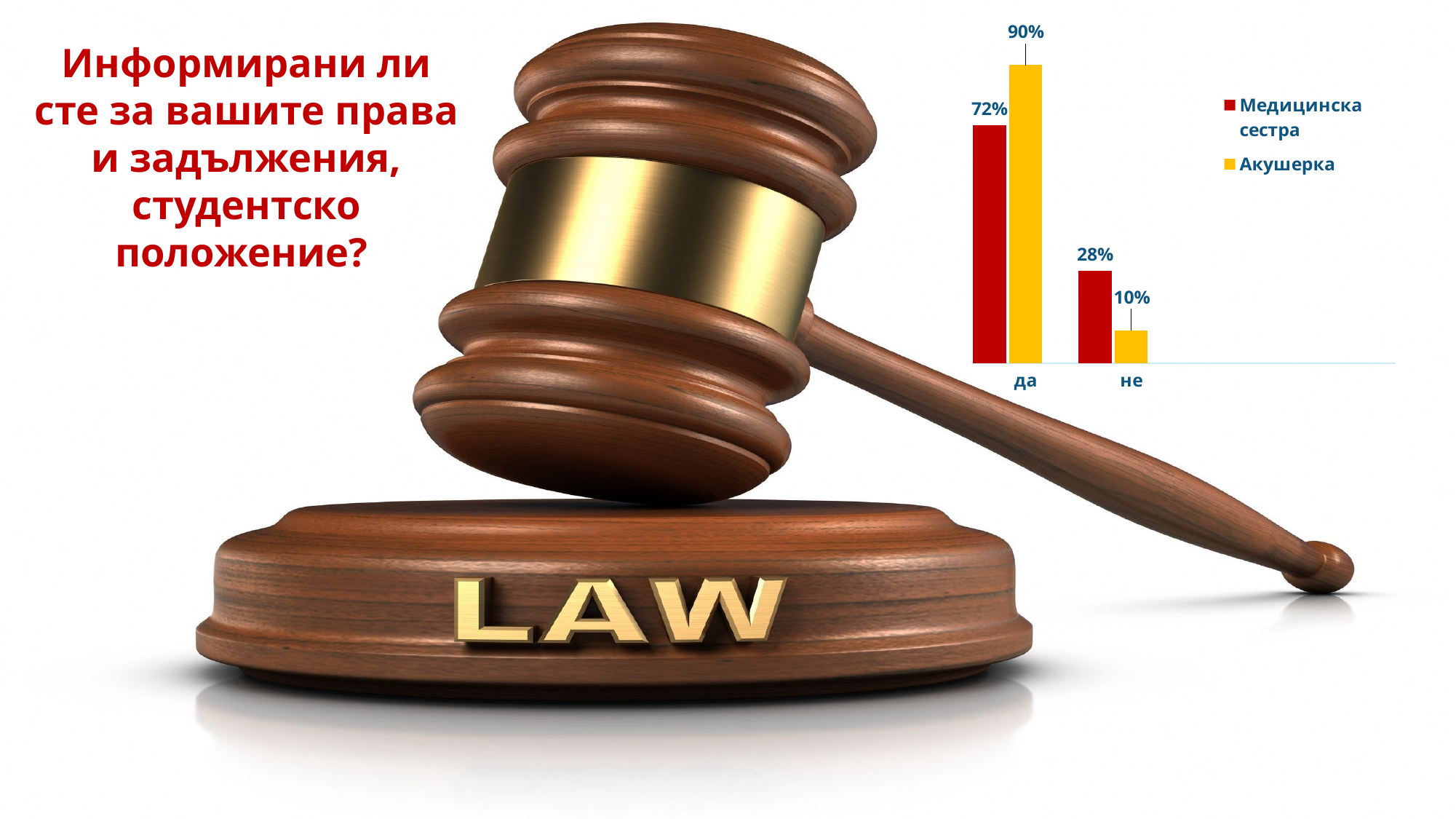
What is the value for Акушерка in the да category? 90% What is the difference between the Акушерка and Медицинска сестра values in the да category? 18% What is the value for Медицинска сестра in the не category? 28% How many categories are shown on the x axis? 2 What is the value for Медицинска сестра in the да category? 72% How many series does the legend list? 2 Which series has the lowest value in the не category? Акушерка Which is larger: Медицинска сестра for да or Медицинска сестра for не? Медицинска сестра for да What is the value for Акушерка in the не category? 10% What kind of chart is shown on the slide? Bar chart Which series has the highest value in the да category? Акушерка What is the difference between the Медицинска сестра and Акушерка values in the не category? 18%